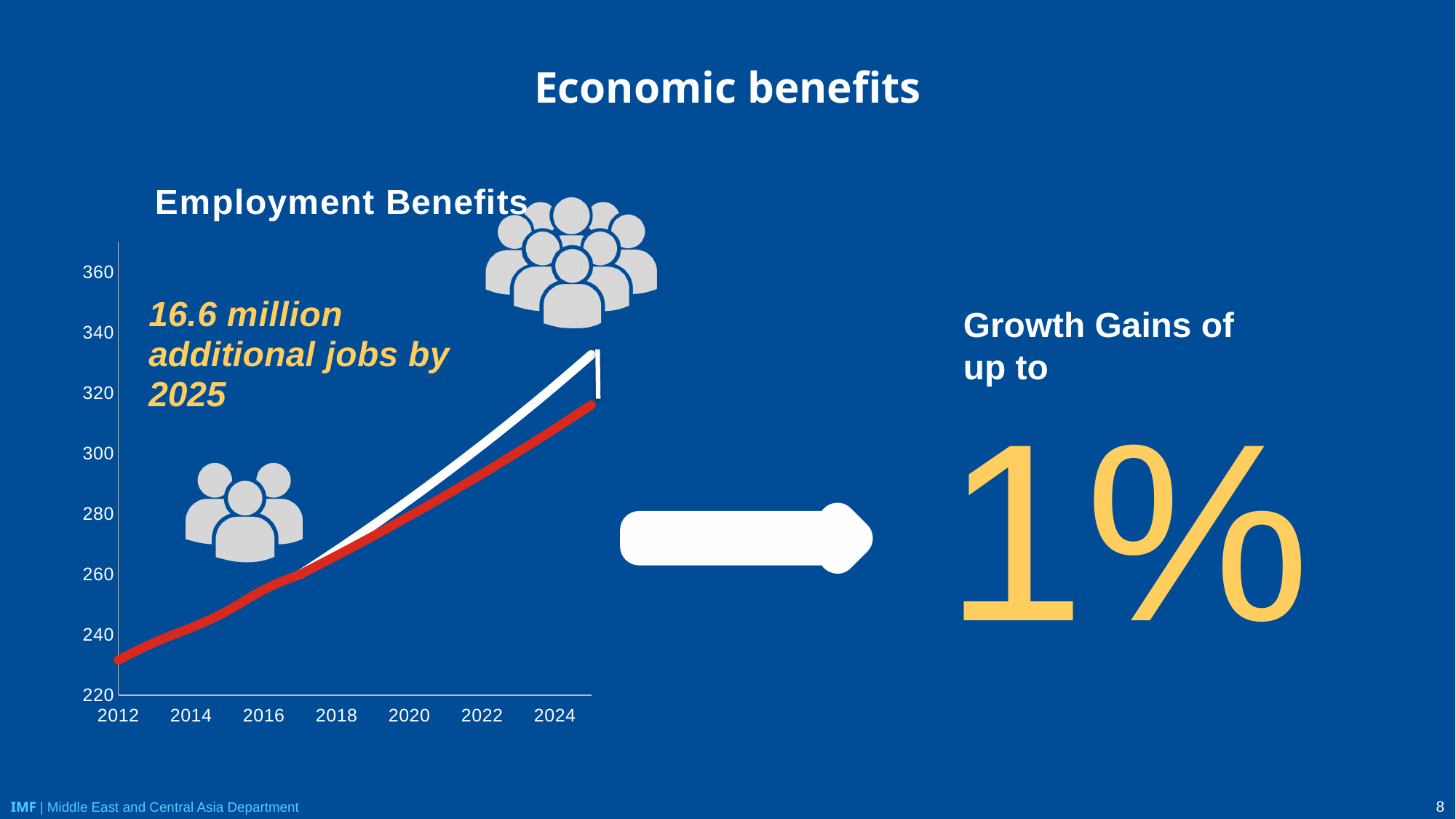
What is the title of the chart on the slide? Employment Benefits In the Employment Benefits chart, is the value of the red line in 2024 greater or less than 300? greater How many lines are plotted in the Employment Benefits chart? 2 In the Employment Benefits chart, is the value of the red line in 2016 greater or less than 260? less What kind of chart is shown under the heading "Employment Benefits"? line chart In the Employment Benefits chart, is the value of the red line in 2012 greater or less than 240? less In the Employment Benefits chart, do the plotted values rise or fall from 2012 to 2024? rise What is the lowest value shown on the y axis of the Employment Benefits chart? 220 How many year labels are shown on the x axis of the Employment Benefits chart? 7 In the Employment Benefits chart, which line is higher in 2024, the white line or the red line? the white line